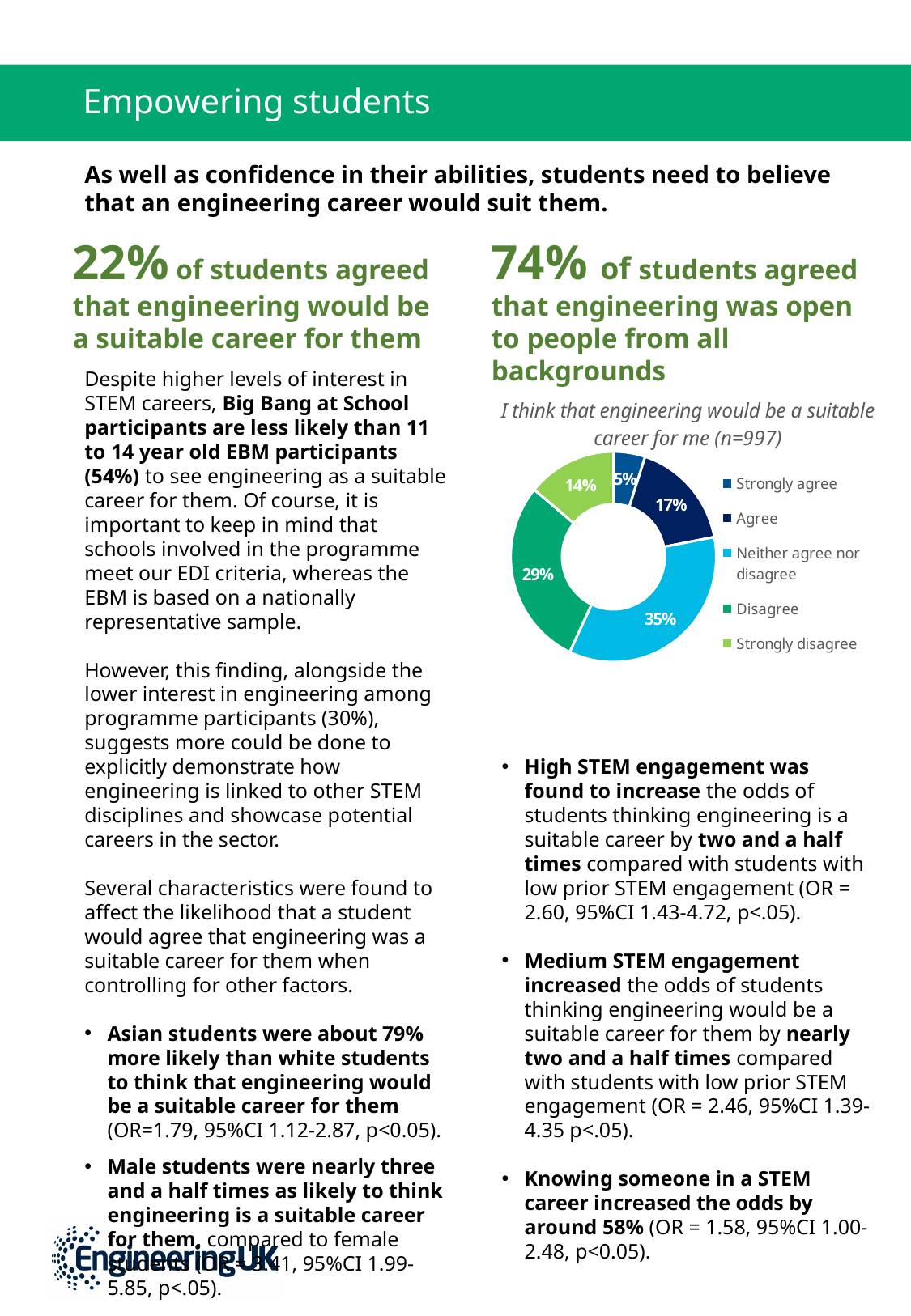
What percentage of students selected 'Neither agree nor disagree' in the chart? 35% What is the combined percentage of 'Strongly agree' and 'Agree' in the chart? 22% What kind of chart is shown on the slide? Donut (pie) chart Which response category has the smallest share in the chart? Strongly agree What is the difference in percentage points between 'Disagree' and 'Agree' in the chart? 12 What percentage of students selected 'Strongly agree' in the chart? 5% How many response categories are shown in the chart? 5 Which response category has the largest share in the chart? Neither agree nor disagree Which is larger in the chart, the share for 'Agree' or the share for 'Strongly disagree'? Agree What percentage of students selected 'Disagree' in the chart? 29% What is the sample size (n) stated in the chart title? 997 What percentage of students selected 'Strongly disagree' in the chart? 14%